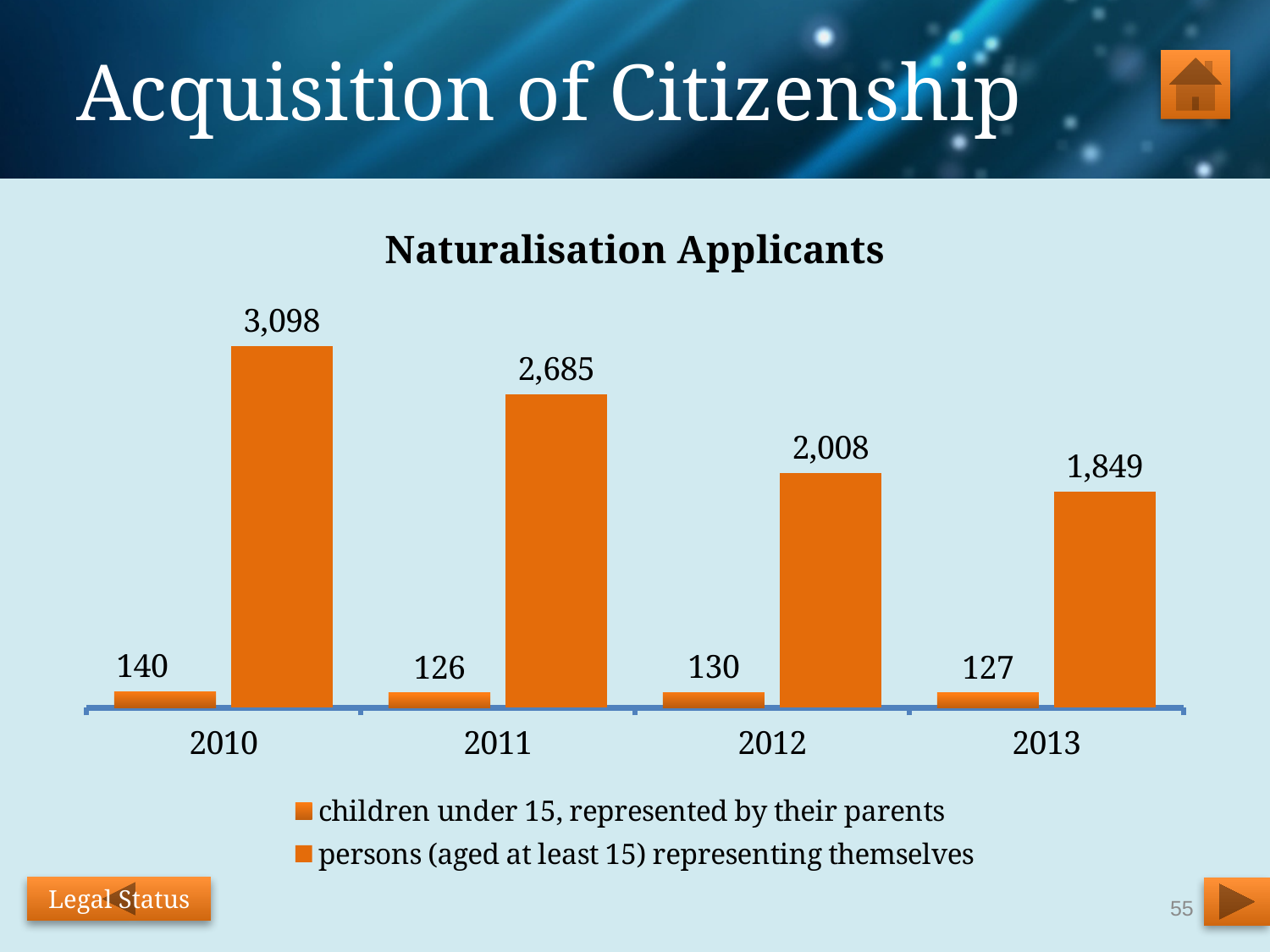
What kind of chart is shown on the slide? bar chart What is the value for children under 15, represented by their parents in 2012? 130 Which year has the highest value for persons (aged at least 15) representing themselves? 2010 What is the difference between the persons (aged at least 15) representing themselves values for 2011 and 2012? 677 Which year has the lowest value for children under 15, represented by their parents? 2011 How many series does the legend list? 2 How many years are shown on the x axis? 4 What is the title of the chart? Naturalisation Applicants What is the value for persons (aged at least 15) representing themselves in 2013? 1,849 What is the value for persons (aged at least 15) representing themselves in 2010? 3,098 Do the values for persons (aged at least 15) representing themselves rise or fall from 2010 to 2013? fall Which is larger: the children under 15 value for 2010 or for 2013? 2010